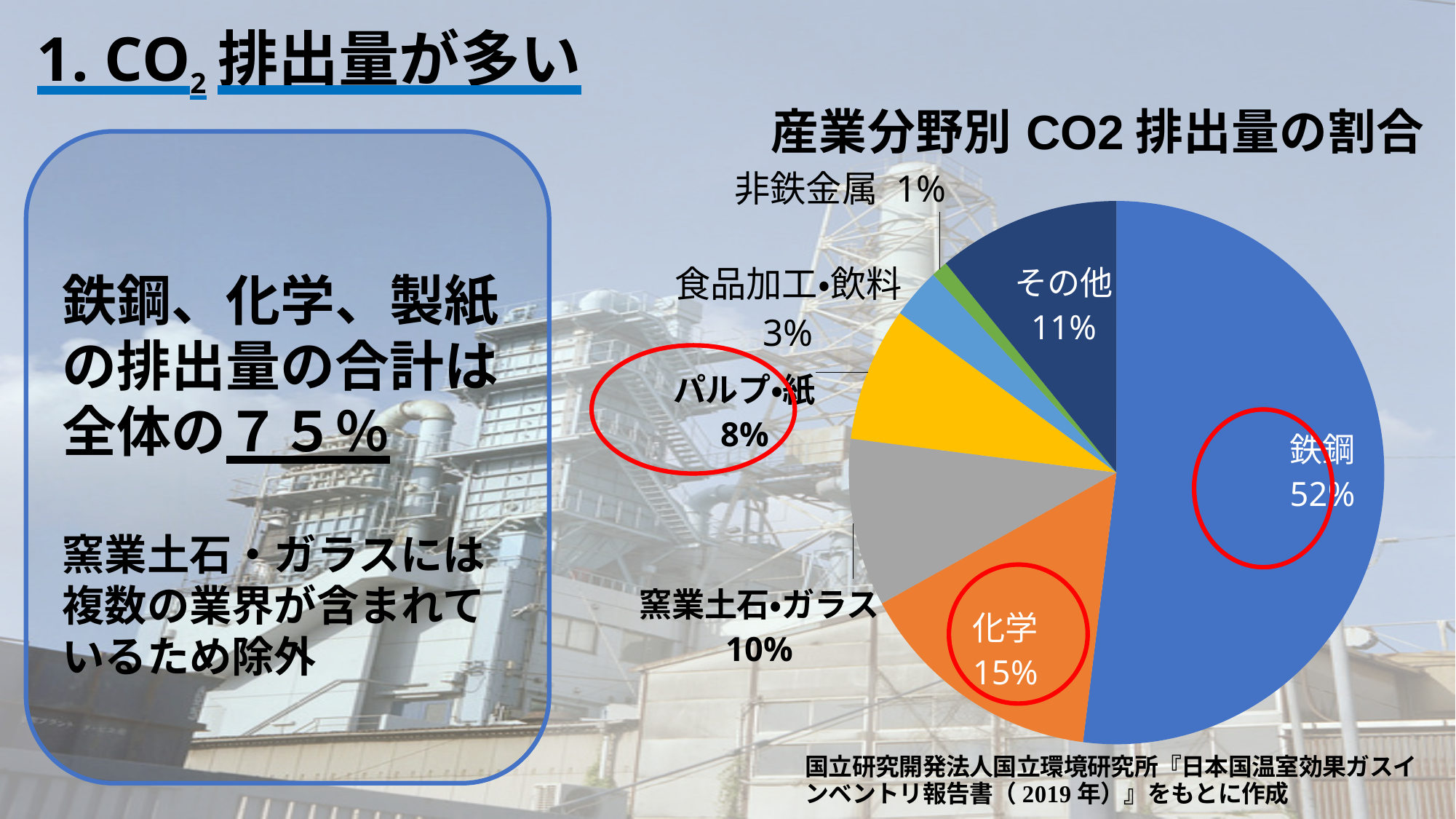
What percentage is labelled for 非鉄金属? 1% Which category has the largest slice of the pie chart? 鉄鋼 What share of CO2 emissions does 鉄鋼 account for in the pie chart? 52% What is the difference between the shares of 鉄鋼 and 化学? 37% How many slices does the pie chart have? 7 Which category has the smallest slice of the pie chart? 非鉄金属 Which is larger, the share of その他 or the share of 窯業土石・ガラス? その他 What percentage is shown for 窯業土石・ガラス? 10% What type of chart is shown on the slide? pie chart What is the title of the chart? 産業分野別 CO2 排出量の割合 What is the value for パルプ・紙 in the pie chart? 8% What is the value shown for 化学 in the pie chart? 15%